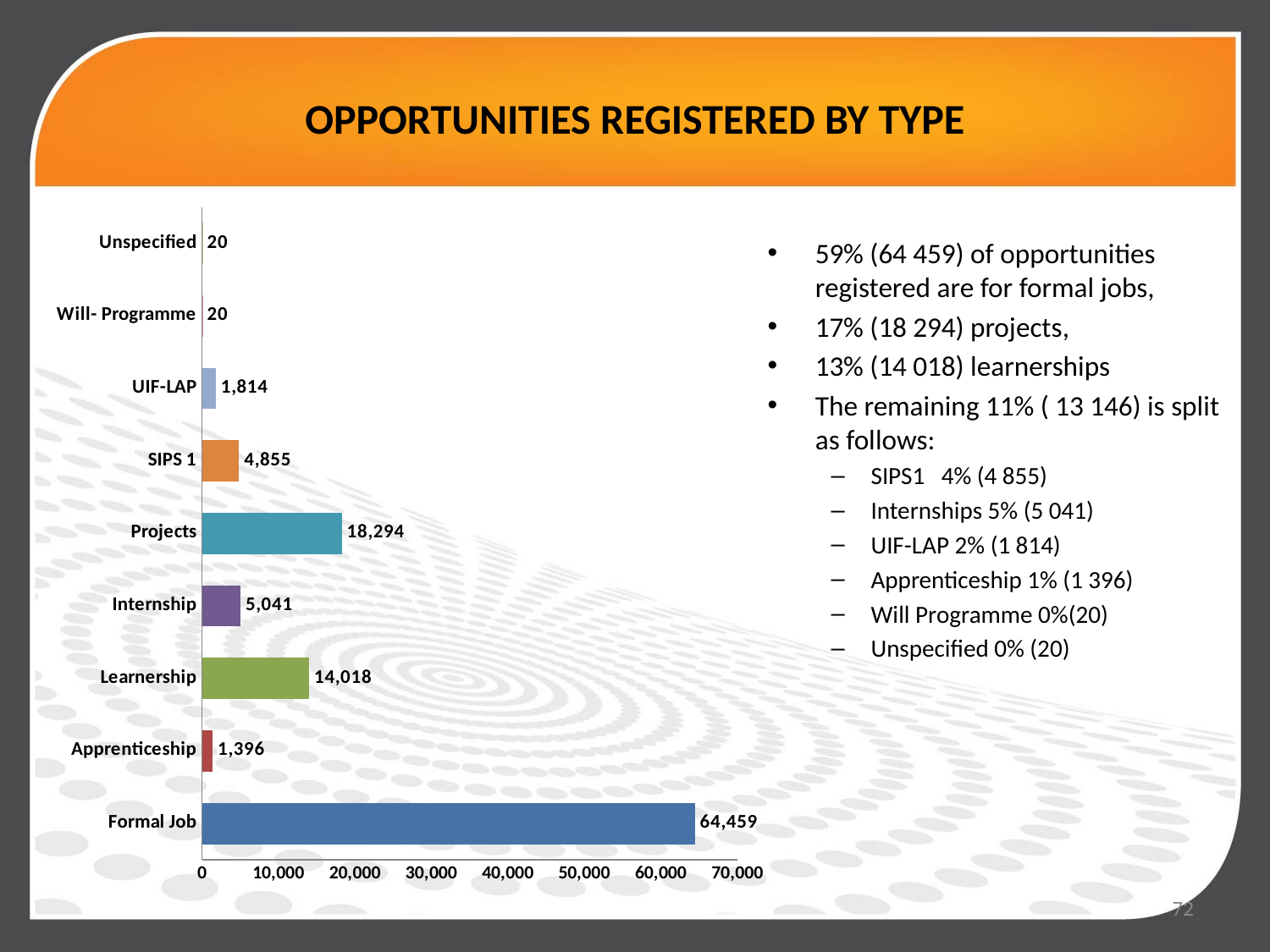
What is the value for Projects? 18,294 What is the title of the slide containing the chart? OPPORTUNITIES REGISTERED BY TYPE Is the value for Formal Job greater or less than 60,000? greater How many categories are shown in the chart? 9 Which category has the highest value? Formal Job What is the value for UIF-LAP? 1,814 What is the value for Learnership? 14,018 What is the difference between the values for Projects and Learnership? 4,276 What is the value for Formal Job? 64,459 What kind of chart is shown on the slide? bar chart What is the difference between the values for Formal Job and Projects? 46,165 Which is larger, the value for Internship or the value for SIPS 1? Internship